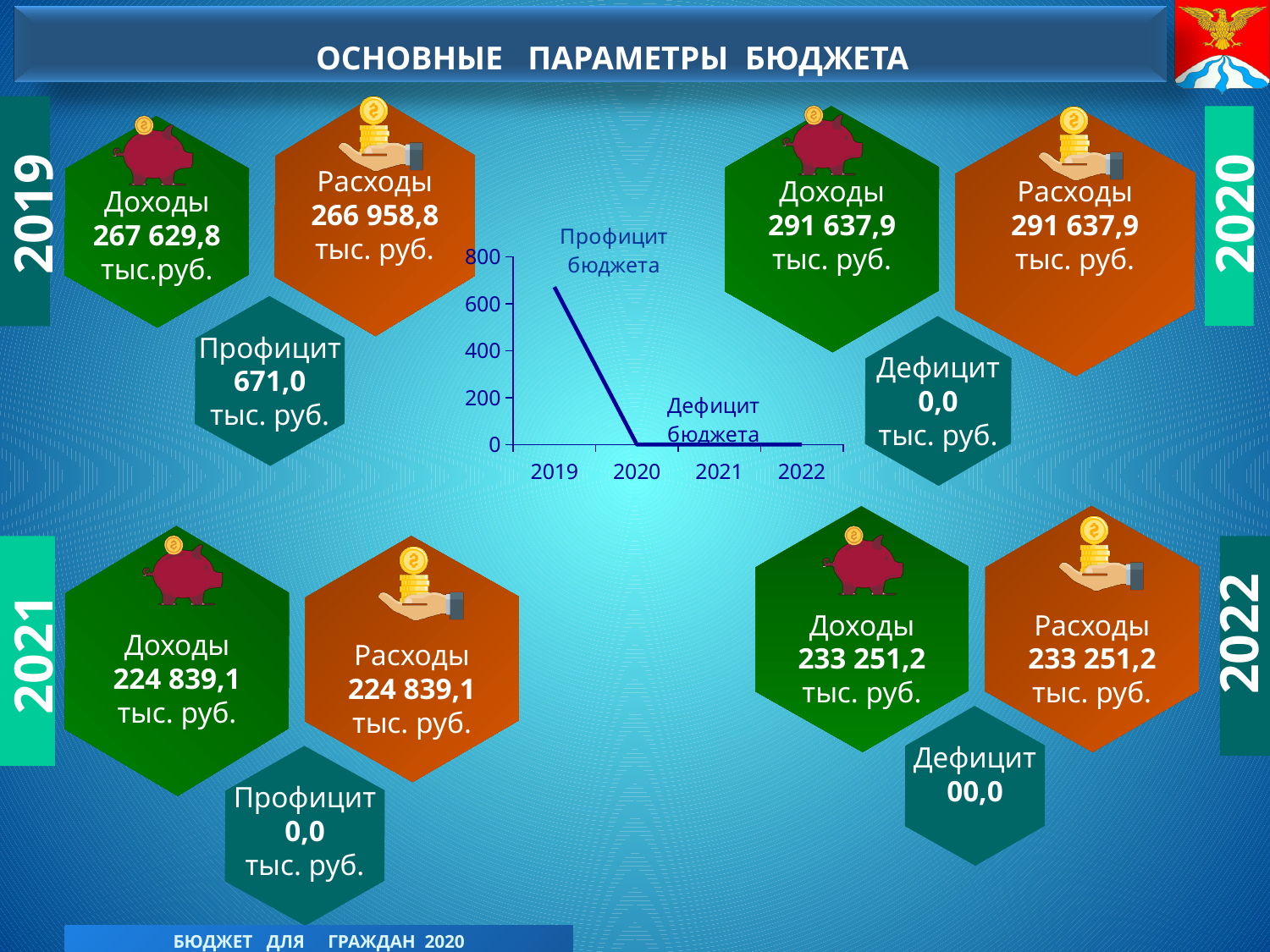
What value does the line chart show for 2021? 0 What value does the line chart show for 2020? 0 How many years are shown on the x axis of the line chart? 4 Which year has the highest value on the line chart? 2019 What value does the line chart show for 2022? 0 Which is larger on the line chart, the value for 2019 or the value for 2020? 2019 Does the line on the chart rise or fall from 2019 to 2020? fall Is the value for 2019 on the line chart greater or less than 800? less Is the value for 2019 on the line chart greater or less than 600? greater What kind of chart is shown in the centre of the slide? line chart What is the highest tick value shown on the y axis of the line chart? 800 What label is written above the start of the line on the chart? Профицит бюджета